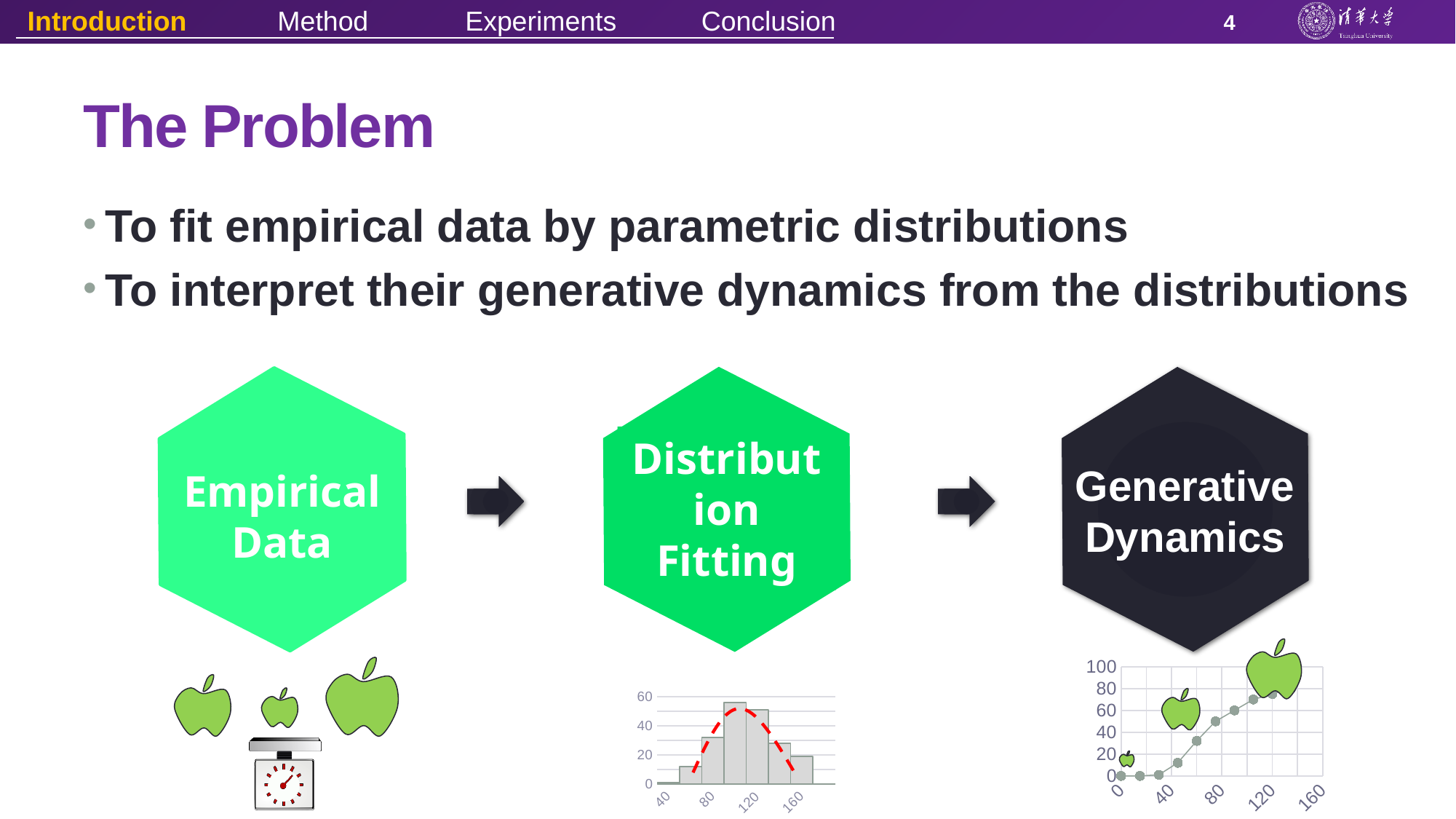
What is the highest tick on the y axis of the chart below 'Generative Dynamics'? 100 In the chart below 'Distribution Fitting', which is taller: the third bar or the last bar? the third bar How many bars are in the chart below 'Distribution Fitting'? 6 In the chart below 'Generative Dynamics', do the values rise or fall as x increases from 0 to 120? rise What kind of chart is shown below the 'Generative Dynamics' hexagon? line chart In the chart below 'Generative Dynamics', is the value at x = 40 greater or less than 20? less What kind of chart is shown below the 'Distribution Fitting' hexagon? bar chart What colour is the dashed curve overlaid on the chart below 'Distribution Fitting'? red In the chart below 'Distribution Fitting', which bar is the tallest? the third bar from the left In the chart below 'Distribution Fitting', is the tallest bar greater or less than 40? greater In the chart below 'Distribution Fitting', is the first (leftmost) bar greater or less than 20? less